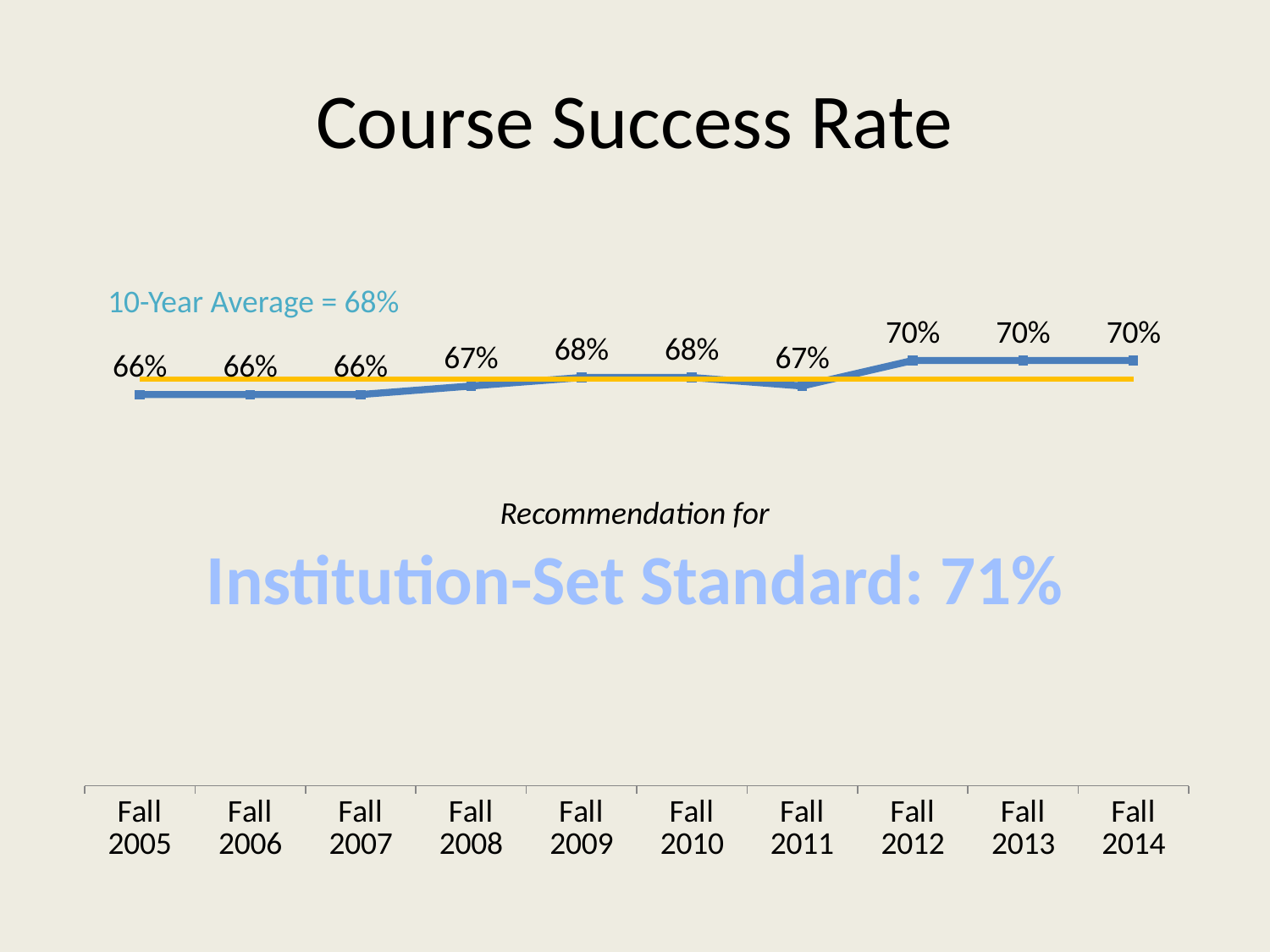
What is the difference between the course success rate in Fall 2014 and Fall 2005? 4% Which year has the lowest course success rate shown first on the chart? Fall 2005 What is the title of the chart? Course Success Rate How many terms are plotted on the x axis? 10 What is the course success rate for Fall 2005? 66% What is the course success rate for Fall 2014? 70% What is the course success rate for Fall 2009? 68% What kind of chart is shown on the slide? Line chart Is the course success rate higher in Fall 2012 or Fall 2008? Fall 2012 Does the course success rate generally rise or fall from Fall 2005 to Fall 2014? Rise What is the course success rate for Fall 2011? 67% What is the 10-year average course success rate stated on the chart? 68%